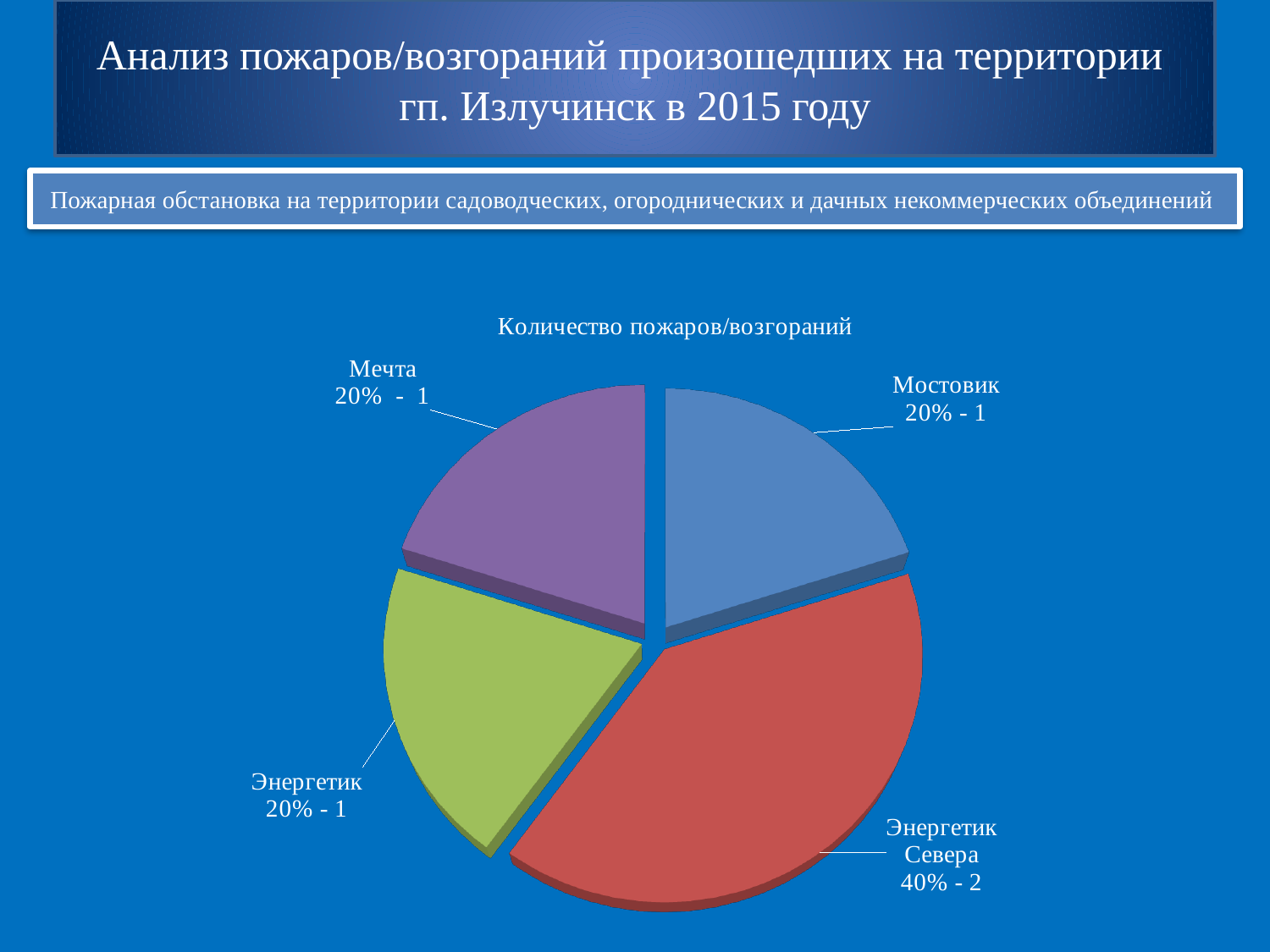
What share of the pie does Энергетик Севера have? 40% How many slices does the pie chart have? 4 What kind of chart is shown on the slide? pie chart What is the title of the chart? Количество пожаров/возгораний What share of the pie does Мостовик have? 20% Which is larger, the slice for Энергетик Севера or the slice for Мостовик? Энергетик Севера How many fires are shown for Энергетик Севера? 2 How many fires are shown for Мечта? 1 Which category has the largest slice? Энергетик Севера What is the total number of fires across all slices? 5 What is the difference in fires between Энергетик Севера and Энергетик? 1 What colour is the slice for Энергетик Севера? red